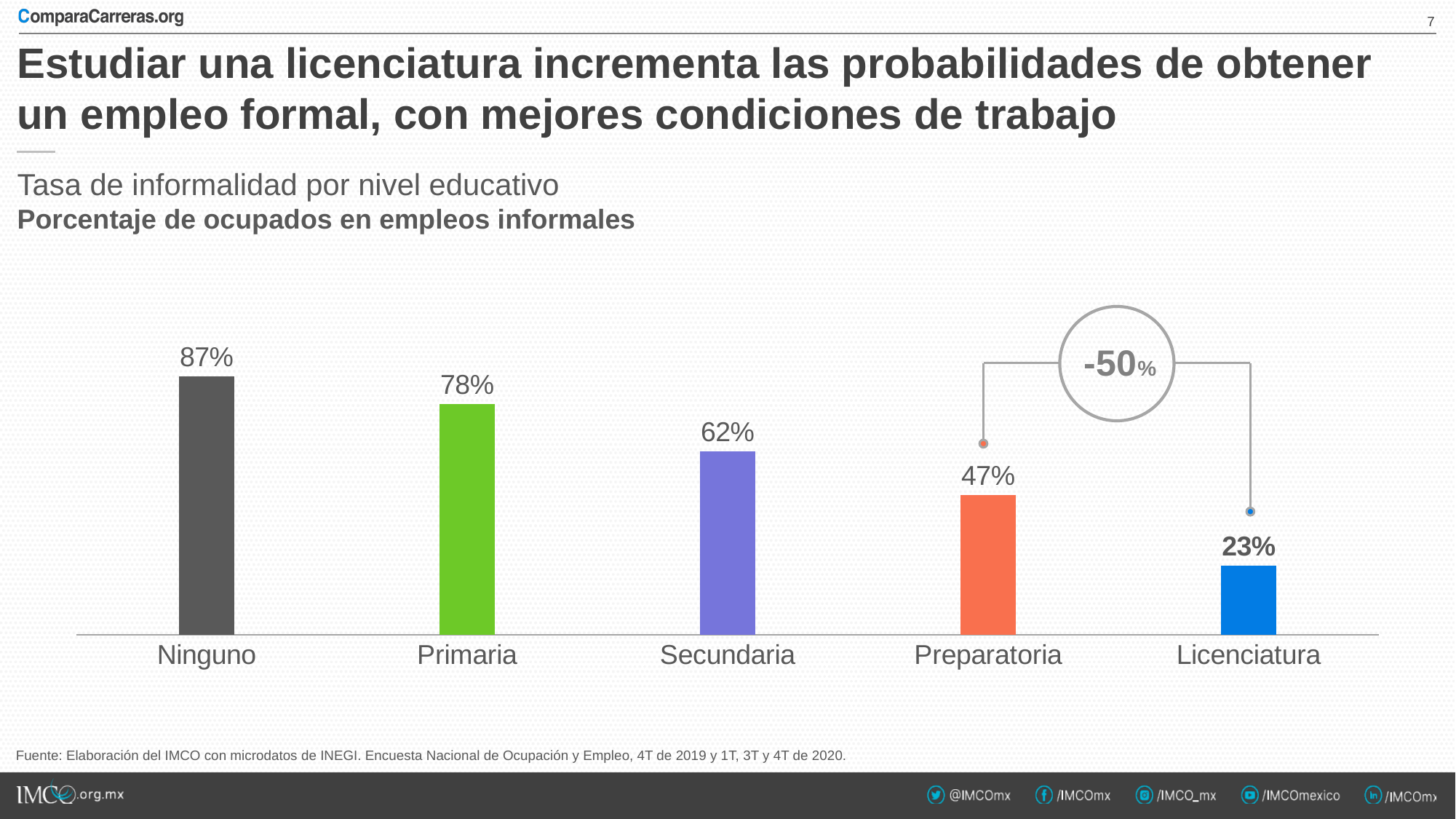
What is the difference in percentage points between Ninguno and Licenciatura? 64 Which education level has the highest informality rate? Ninguno What is the informality rate for Ninguno? 87% What is the informality rate for Licenciatura? 23% What is the difference in percentage points between Primaria and Preparatoria? 31 Which education level has the lowest informality rate? Licenciatura What is the informality rate for Secundaria? 62% What kind of chart is shown on the slide? Bar chart Do the values rise or fall from Ninguno to Licenciatura? Fall Which has a higher informality rate, Secundaria or Preparatoria? Secundaria How many education levels are shown on the chart? 5 What percentage change is shown in the circle between Preparatoria and Licenciatura? -50%